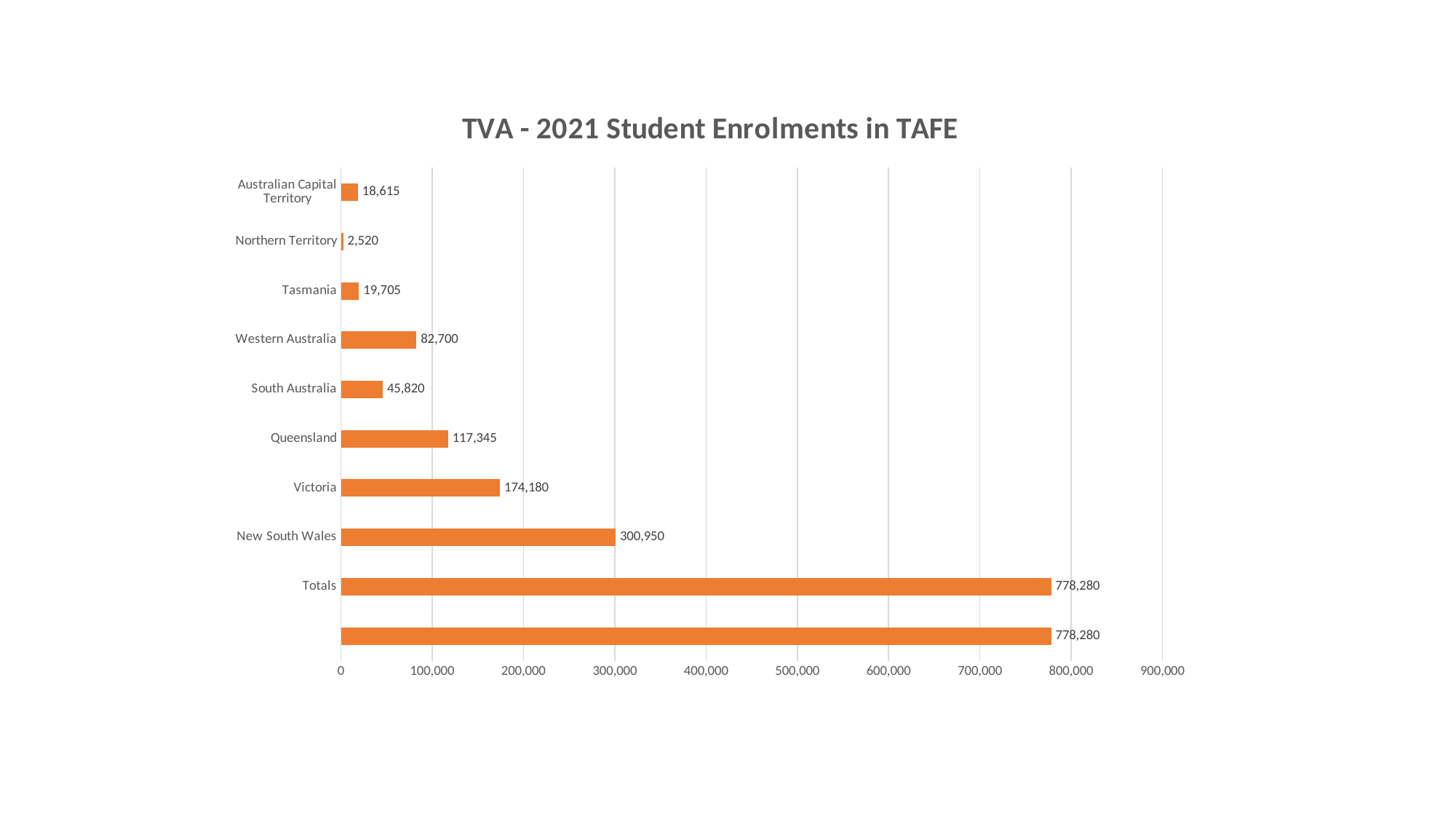
What is the value for Northern Territory? 2,520 What is the value shown for Totals? 778,280 What kind of chart is shown on the slide? bar chart What is the title of the chart? TVA - 2021 Student Enrolments in TAFE Is the value for Victoria greater or less than 200,000? less Which is larger, the value for Tasmania or the value for Australian Capital Territory? Tasmania What is the value for New South Wales? 300,950 What is the difference between the values for Queensland and Western Australia? 34,645 Excluding the Totals bar, which state or territory has the highest enrolments? New South Wales What is the difference between the values for New South Wales and Victoria? 126,770 Which state or territory has the lowest enrolments? Northern Territory What is the value for Western Australia? 82,700